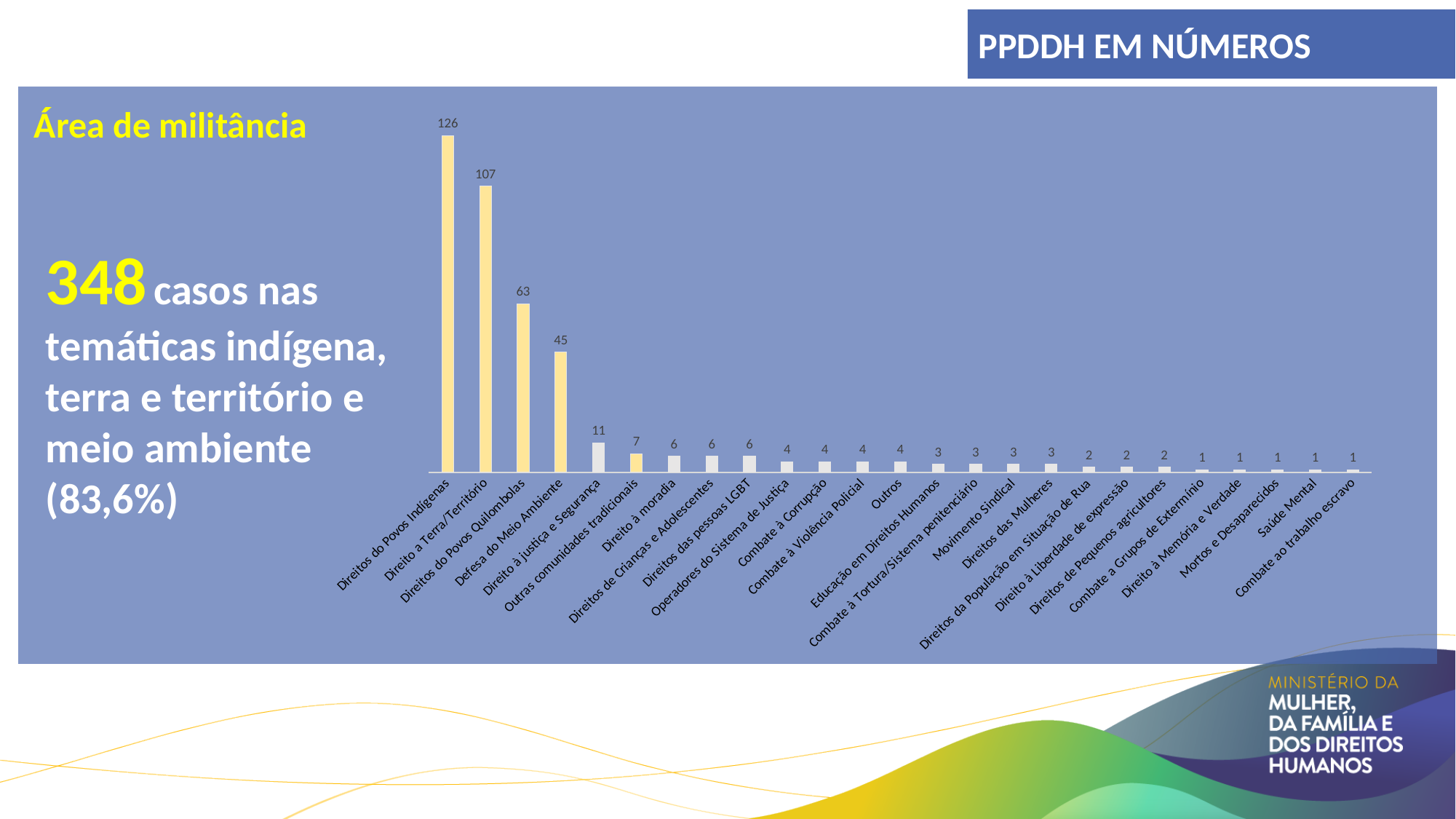
What is the value for Direito a Terra/Território? 107 Which category has the highest value? Direitos do Povos Indígenas Do the values rise or fall from left to right along the x axis? Fall How many categories are shown on the chart? 25 What kind of chart is shown on the slide? Bar chart What is the value for Direitos do Povos Indígenas? 126 Which is larger, Direitos do Povos Quilombolas or Direito à Justiça e Segurança? Direitos do Povos Quilombolas What is the difference between Direitos do Povos Indígenas and Direito a Terra/Território? 19 What is the value for Defesa do Meio Ambiente? 45 What is the lowest value shown on the chart? 1 What is the value for Direito à Justiça e Segurança? 11 What is the difference between Direitos do Povos Quilombolas and Defesa do Meio Ambiente? 18